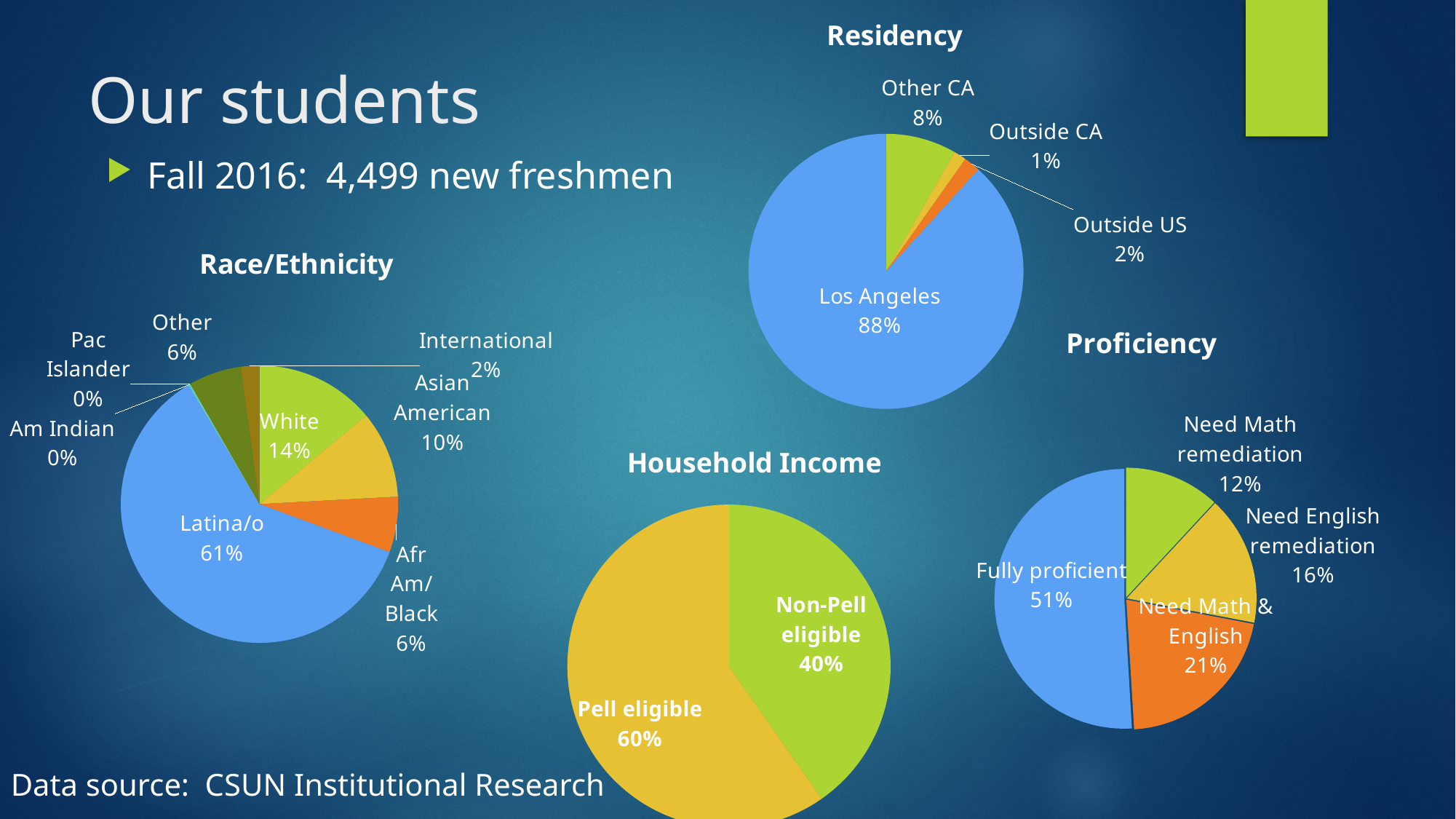
How many pie charts are on the slide? 4 In the Race/Ethnicity chart, what share of students are Latina/o? 61% In the Residency chart, what share of students are from Los Angeles? 88% In the Residency chart, how many categories are shown? 4 In the Residency chart, which category has the smallest share? Outside CA In the Household Income chart, what share of students are Pell eligible? 60% In the Proficiency chart, what share of students need Math & English remediation? 21% In the Proficiency chart, which is larger: Need Math remediation or Need English remediation? Need English remediation In the Household Income chart, what is the difference between the Pell eligible and Non-Pell eligible shares? 20% In the Race/Ethnicity chart, what is the difference between the White share and the Asian American share? 4% What kind of chart is the Household Income chart? Pie chart In the Race/Ethnicity chart, which category has the largest share? Latina/o